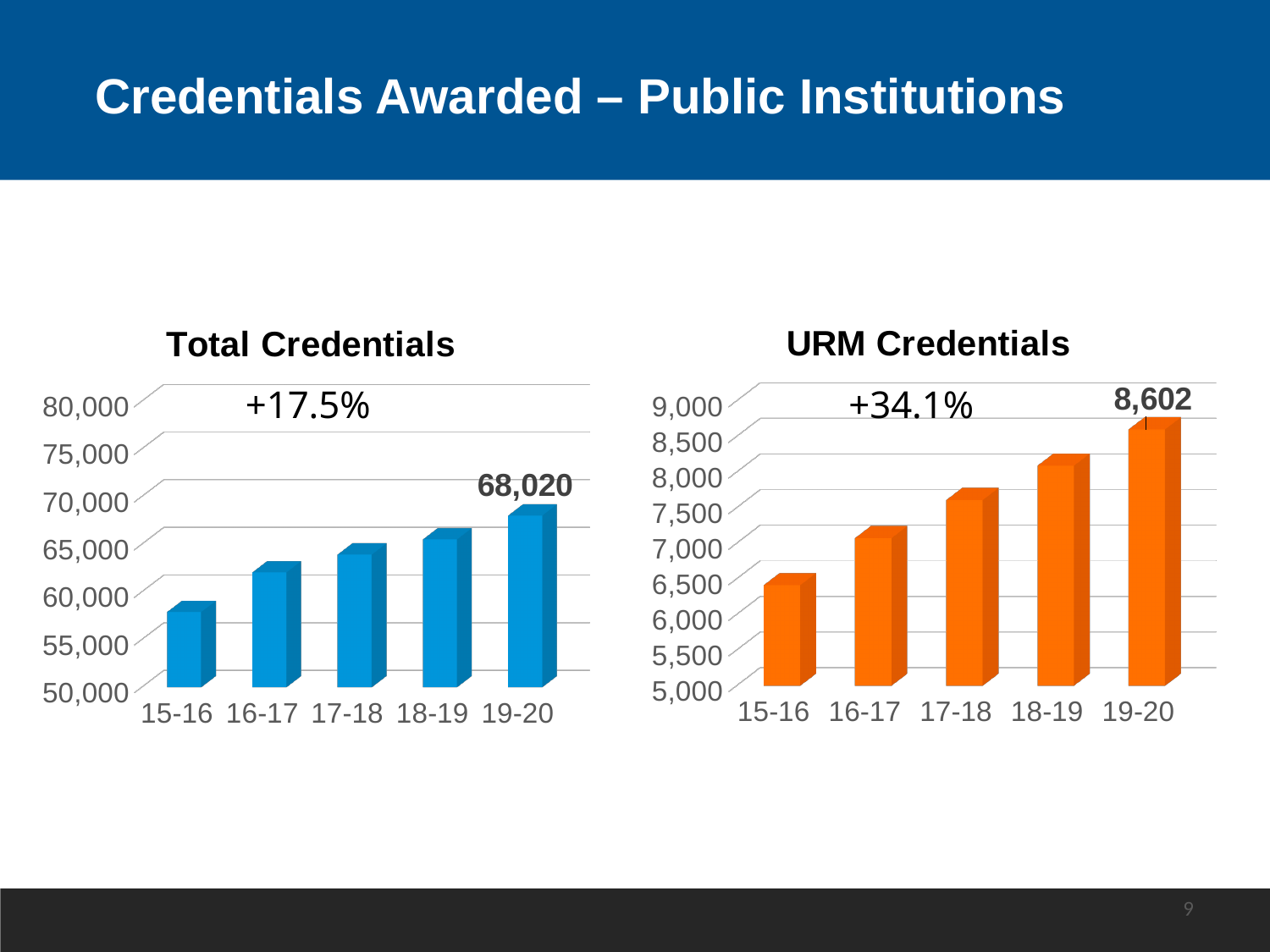
In the URM Credentials chart, which year has the lowest value? 15-16 In the Total Credentials chart, what is the value for 19-20? 68,020 In the Total Credentials chart, which is larger, the value for 16-17 or the value for 18-19? 18-19 In the Total Credentials chart, is the value for 15-16 greater or less than 60,000? less What percentage change is annotated on the Total Credentials chart? +17.5% What kind of chart is the Total Credentials chart? bar chart What percentage change is annotated on the URM Credentials chart? +34.1% In the URM Credentials chart, is the value for 17-18 greater or less than 7,500? greater In the URM Credentials chart, what is the value for 19-20? 8,602 How many bars are in the URM Credentials chart? 5 In the URM Credentials chart, do the values rise or fall from 15-16 to 19-20? rise In the Total Credentials chart, which year has the highest value? 19-20